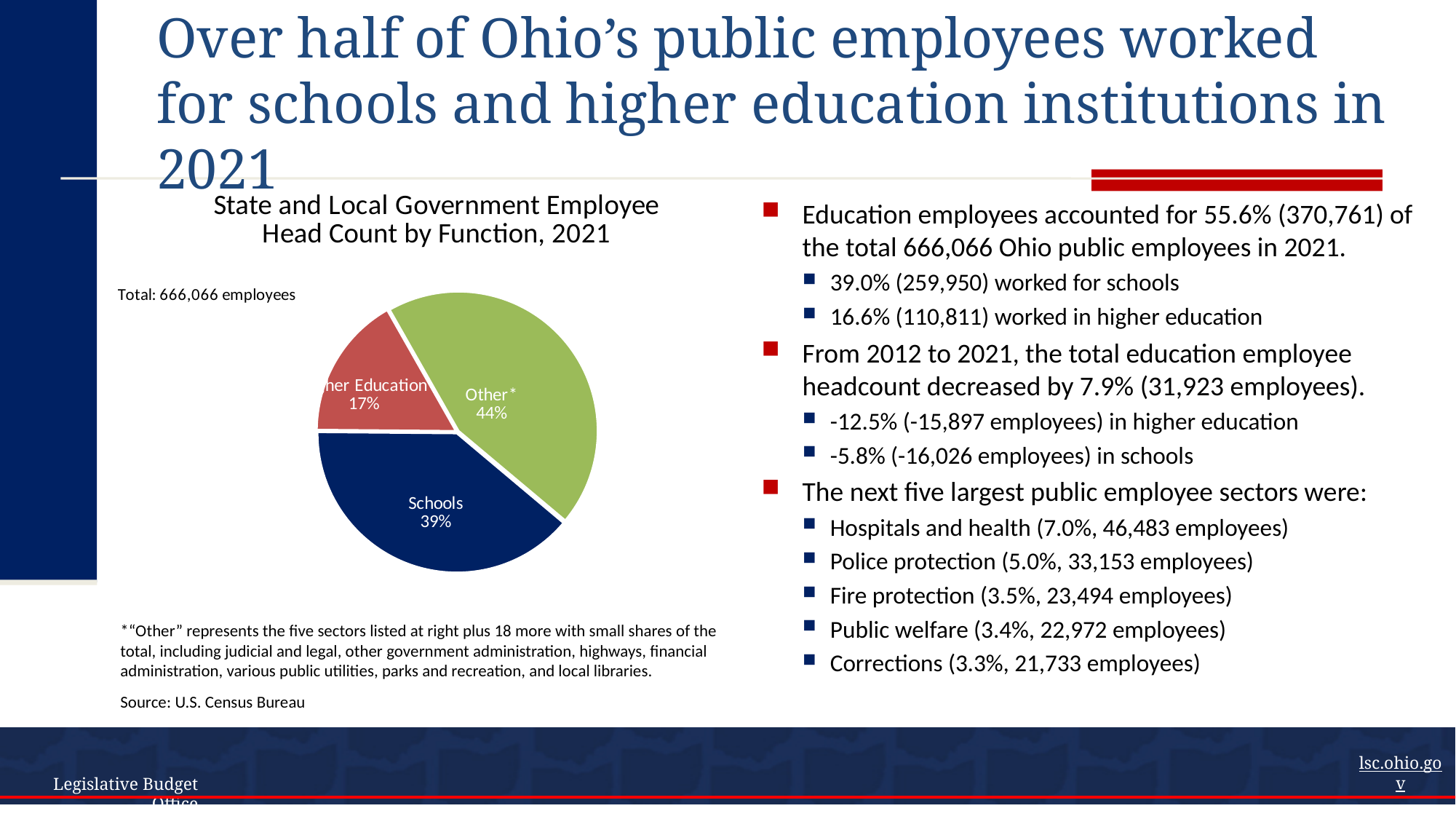
What share of the pie does the Other* slice represent? 44% What is the title of the pie chart? State and Local Government Employee Head Count by Function, 2021 What is the difference in percentage points between the Other* slice and the Schools slice? 5 percentage points What total number of employees does the pie chart represent, according to the label next to it? 666,066 employees Which slice of the pie chart is the smallest? Higher Education What is the difference in percentage points between the Schools slice and the Higher Education slice? 22 percentage points What share of the pie does the Higher Education slice represent? 17% Which slice of the pie chart is the largest? Other* What kind of chart is shown on the slide? Pie chart Which is larger, the Schools slice or the Higher Education slice? Schools What share of the pie does the Schools slice represent? 39% How many slices does the pie chart have? 3